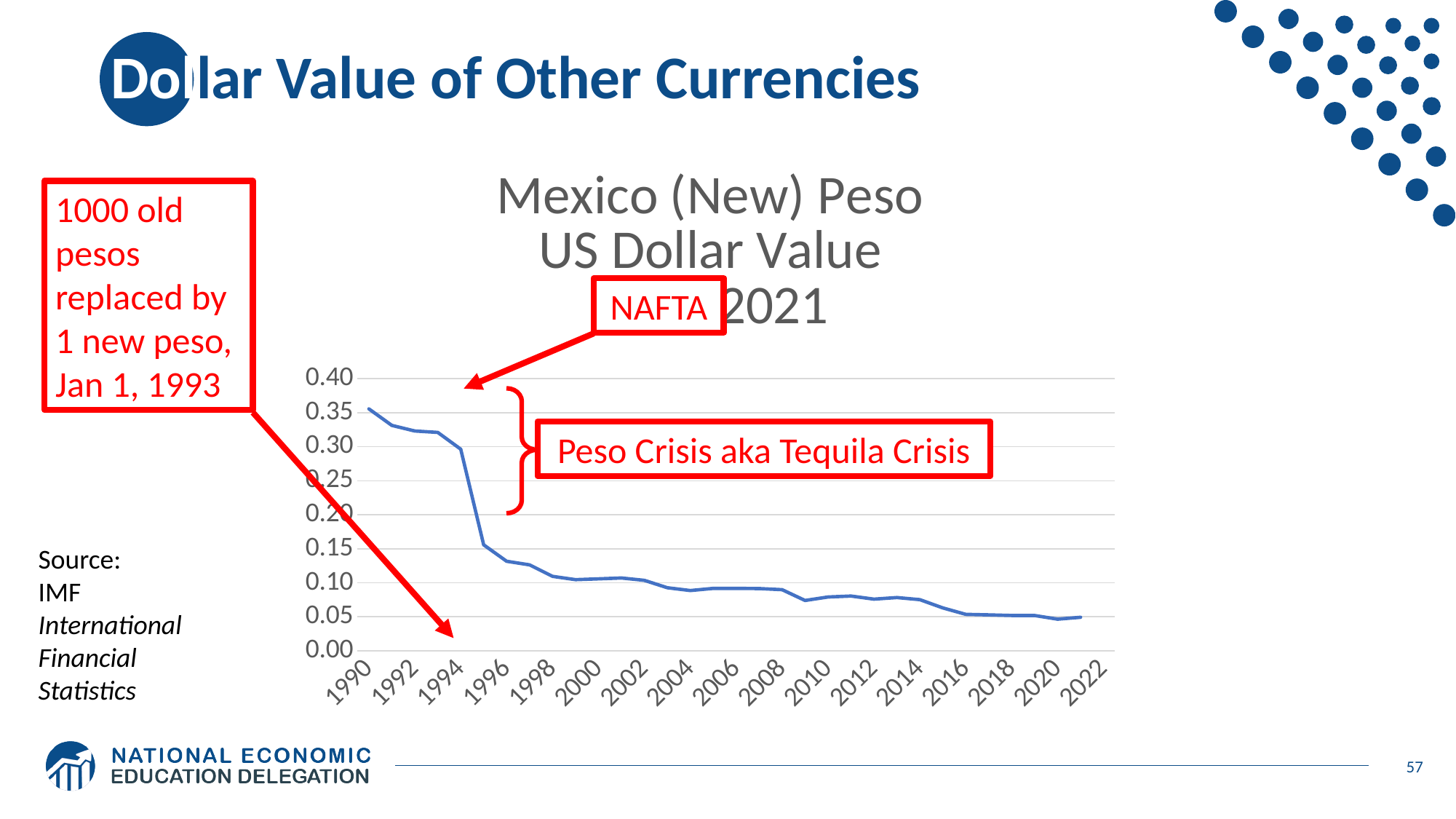
What is the title of the chart? Mexico (New) Peso US Dollar Value 1990-2021 Is the value for 2010 greater or less than 0.10? less Overall, does the US dollar value of the Mexican peso rise or fall from 1990 to 2021? fall How many year labels are shown on the x axis? 17 Is the value for 1994 greater or less than 0.25? greater Which year has the larger value, 1994 or 1996? 1994 Is the value for 1996 greater or less than 0.20? less Which year has the larger value, 1990 or 2000? 1990 In which year is the US dollar value of the peso highest? 1990 What kind of chart is shown on the slide? line chart